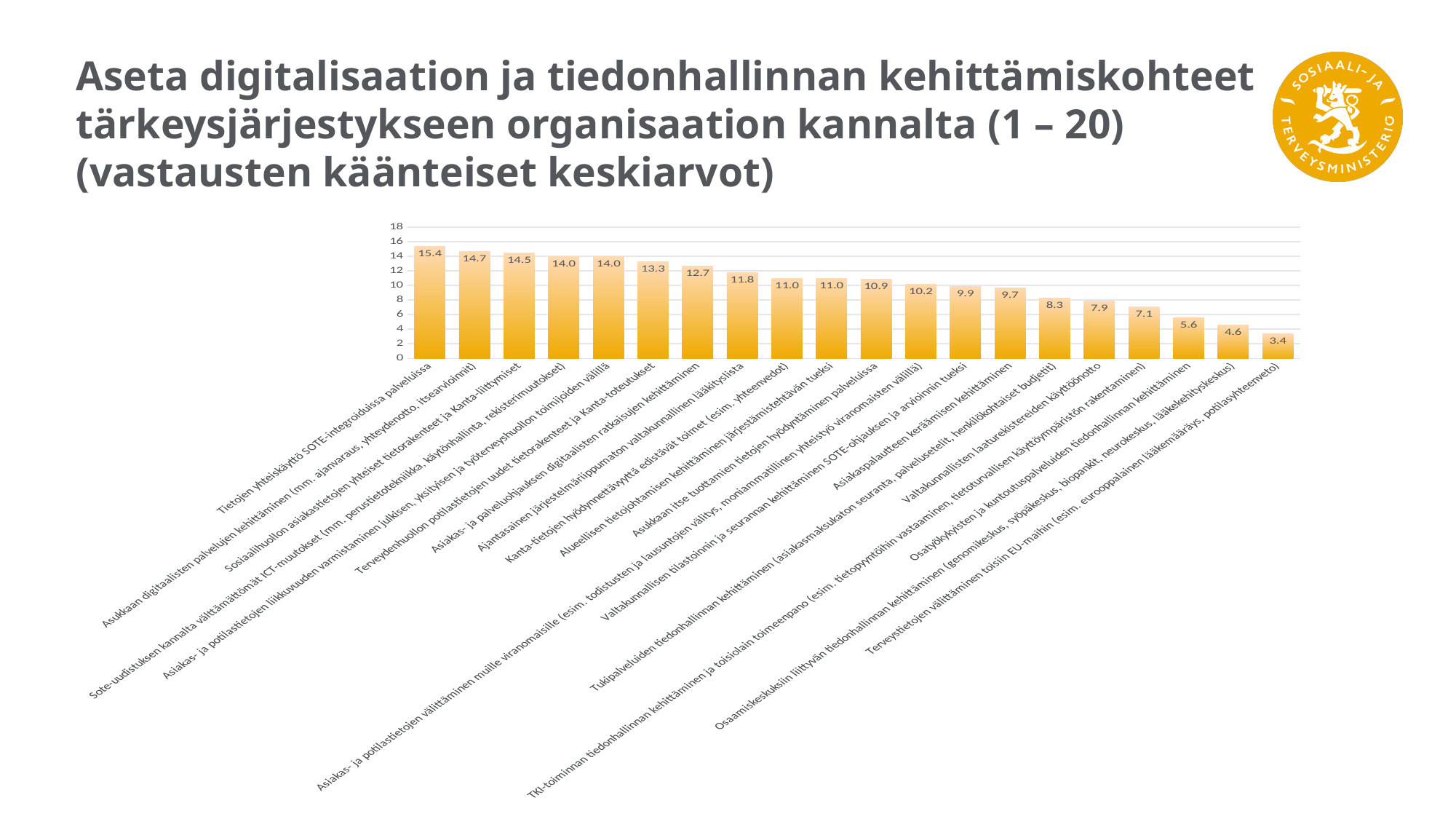
What is the maximum value shown on the vertical axis of the chart? 18 Do the values rise or fall from left to right along the x axis? fall How many bars (categories) does the chart show? 20 What is the lowest value shown in the chart? 3.4 What is the highest value shown in the chart? 15.4 Which category has the lowest value in the chart? Terveystietojen välittäminen toisiin EU-maihin (esim. eurooppalainen lääkemääräys, potilasyhteenveto) Which category has the highest value in the chart? Tietojen yhteiskäyttö SOTE-integroiduissa palveluissa What is the difference between the highest value (15.4) and the lowest value (3.4) in the chart? 12.0 What is the value for 'Asukkaan digitaalisten palvelujen kehittäminen (mm. ajanvaraus, yhteydenotto, itsearvioinnit)'? 14.7 Which is larger: the value for 'Terveydenhuollon potilastietojen uudet tietorakenteet ja Kanta-toteutukset' or the value for 'Asiakas- ja palveluohjauksen digitaalisten ratkaisujen kehittäminen'? Terveydenhuollon potilastietojen uudet tietorakenteet ja Kanta-toteutukset What is the value for 'Ajantasainen järjestelmäriippumaton valtakunnallinen lääkityslista'? 11.8 What type of chart is shown on the slide? bar chart